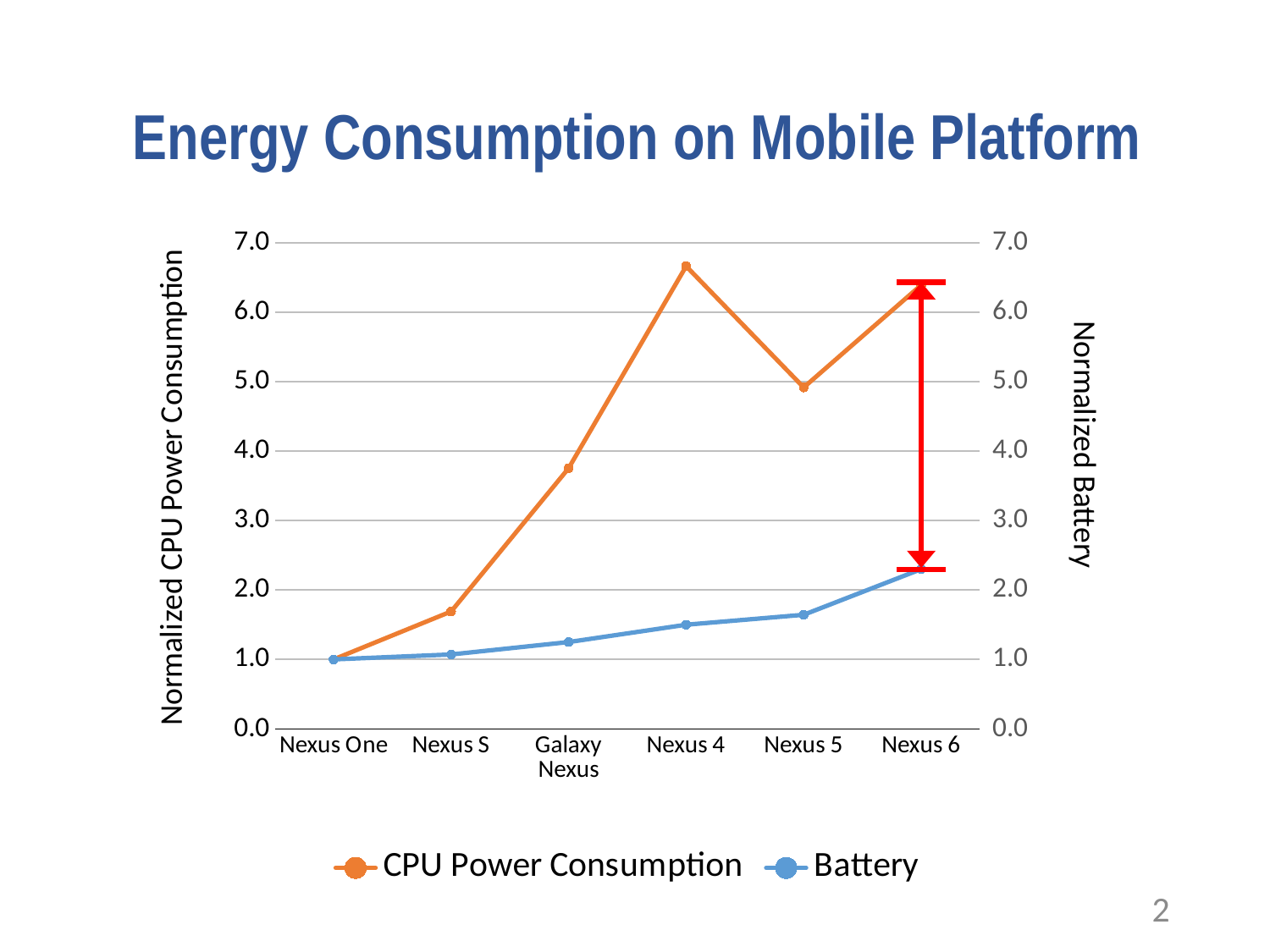
Which device has the highest Battery value? Nexus 6 Which device has the highest CPU Power Consumption value? Nexus 4 Is the CPU Power Consumption value for Galaxy Nexus greater or less than 4.0? less Which device has the lowest CPU Power Consumption value? Nexus One Is the Battery value for Nexus 6 greater or less than 2.0? greater Is the CPU Power Consumption value for Nexus 4 greater or less than 6.0? greater Does the Battery series rise or fall from Nexus One to Nexus 6? rise What kind of chart is shown on the slide? line chart How many series does the legend list? 2 What is the CPU Power Consumption value for Nexus One? 1.0 For Nexus 6, which series has the larger value, CPU Power Consumption or Battery? CPU Power Consumption How many devices are plotted along the x axis? 6